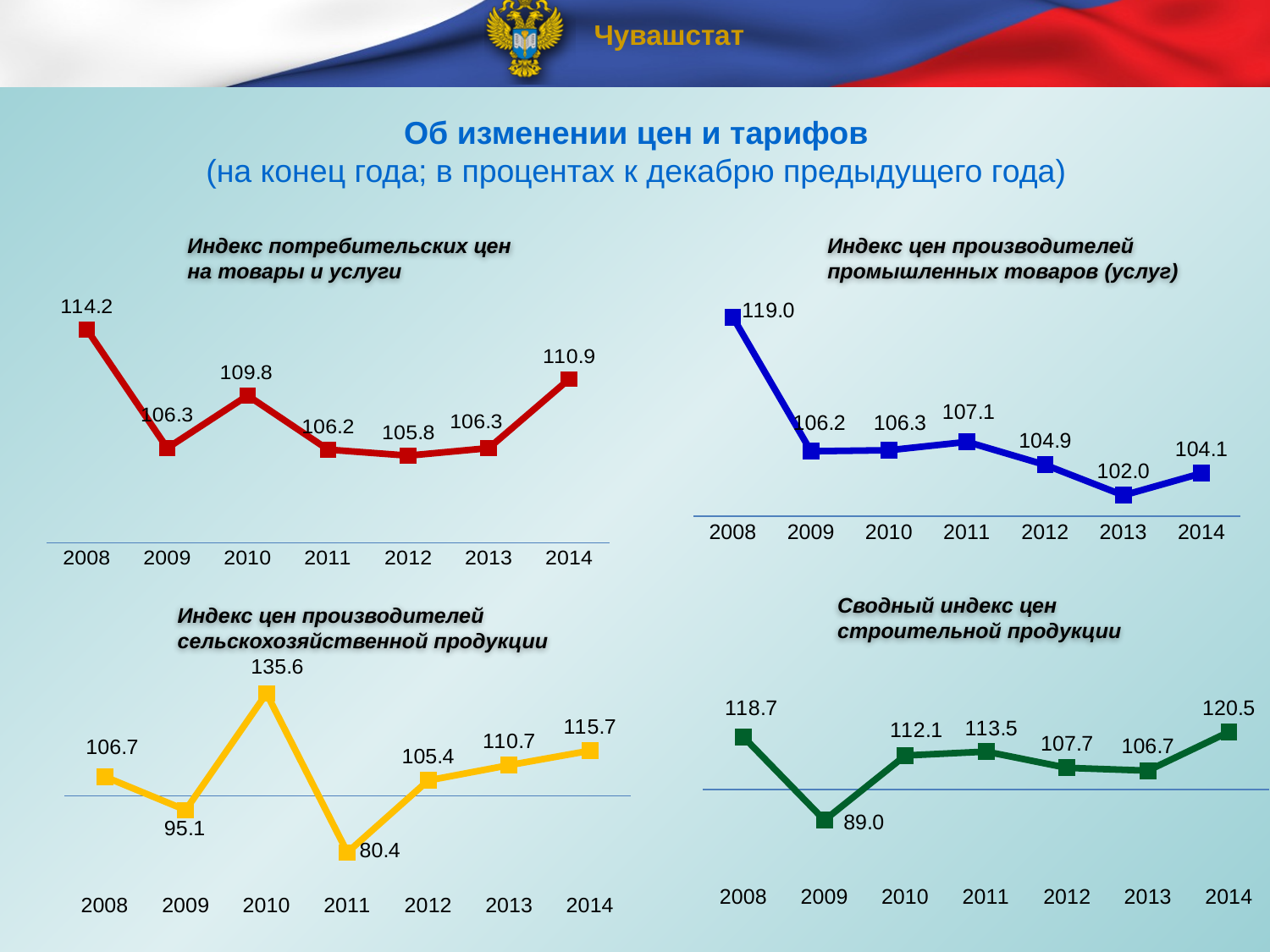
In the top-right chart (Индекс цен производителей промышленных товаров (услуг)), which year has the highest value? 2008 What kind of chart is the bottom-right chart (Сводный индекс цен строительной продукции)? line chart In the top-left chart (Индекс потребительских цен на товары и услуги), what is the difference between the 2008 and 2009 values? 7.9 In the bottom-right chart (Сводный индекс цен строительной продукции), which is larger, the value for 2008 or the value for 2014? 2014 In the bottom-left chart (Индекс цен производителей сельскохозяйственной продукции), what is the value for 2010? 135.6 In the bottom-right chart (Сводный индекс цен строительной продукции), what is the value for 2009? 89.0 In the bottom-left chart (Индекс цен производителей сельскохозяйственной продукции), what is the difference between the 2010 and 2011 values? 55.2 In the top-right chart (Индекс цен производителей промышленных товаров (услуг)), how many years are plotted? 7 In the top-left chart (Индекс потребительских цен на товары и услуги), which year has the lowest value? 2012 In the top-right chart (Индекс цен производителей промышленных товаров (услуг)), what is the value for 2013? 102.0 In the bottom-left chart (Индекс цен производителей сельскохозяйственной продукции), which year has the lowest value? 2011 In the top-left chart (Индекс потребительских цен на товары и услуги), what is the value for 2014? 110.9